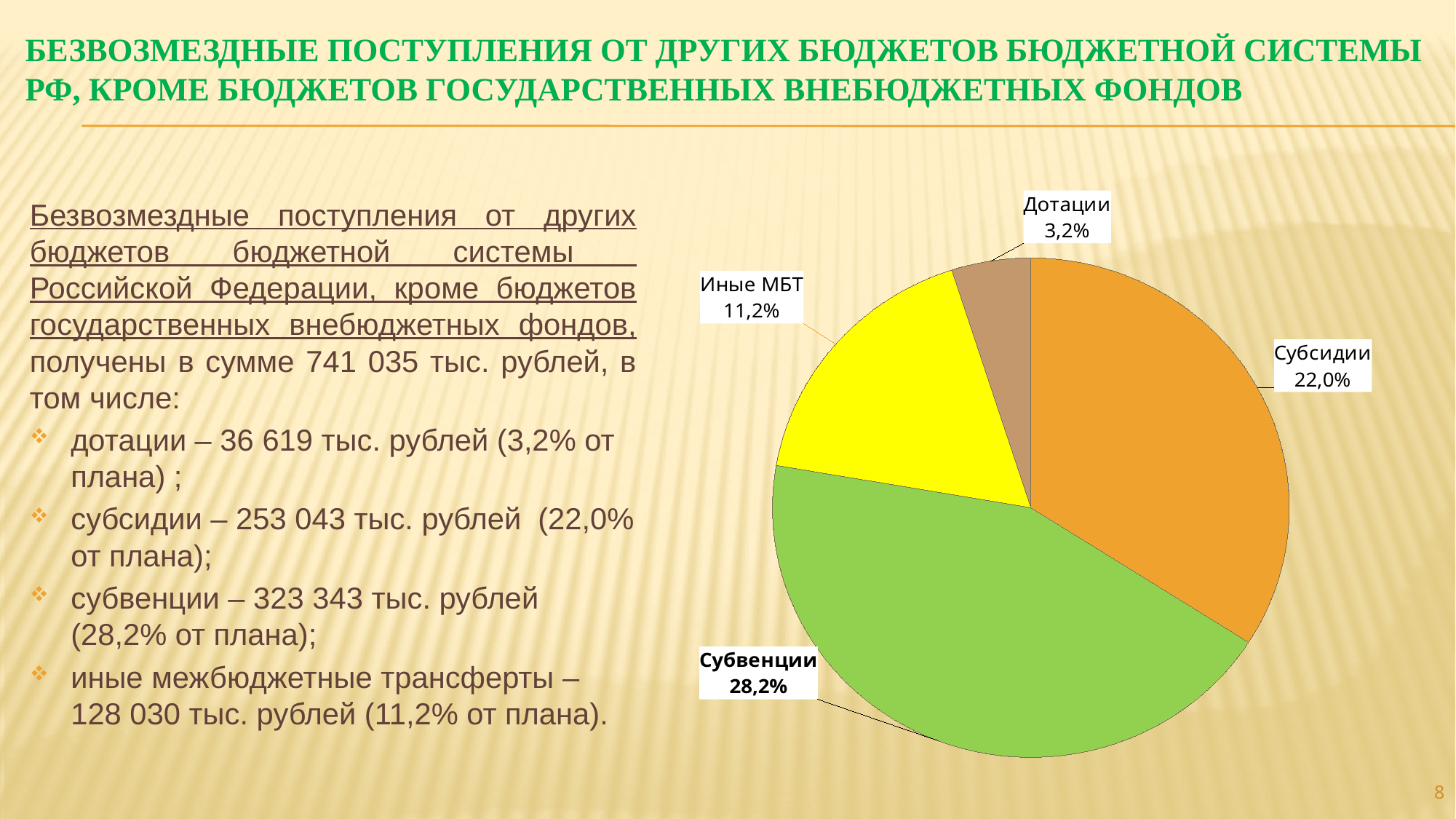
What is the difference between the labelled values for Субвенции and Субсидии? 6,2% Which is larger, the Субсидии slice or the Иные МБТ slice? Субсидии What is the difference between the labelled values for Иные МБТ and Дотации? 8,0% Which slice of the pie chart is the largest? Субвенции What value is labelled for the Дотации slice? 3,2% What value is labelled for the Иные МБТ slice? 11,2% How many slices does the pie chart have? 4 What value is labelled for the Субвенции slice? 28,2% What value is labelled for the Субсидии slice? 22,0% What colour is the Субвенции slice in the pie chart? green Which slice of the pie chart is the smallest? Дотации What kind of chart is shown on the slide? pie chart